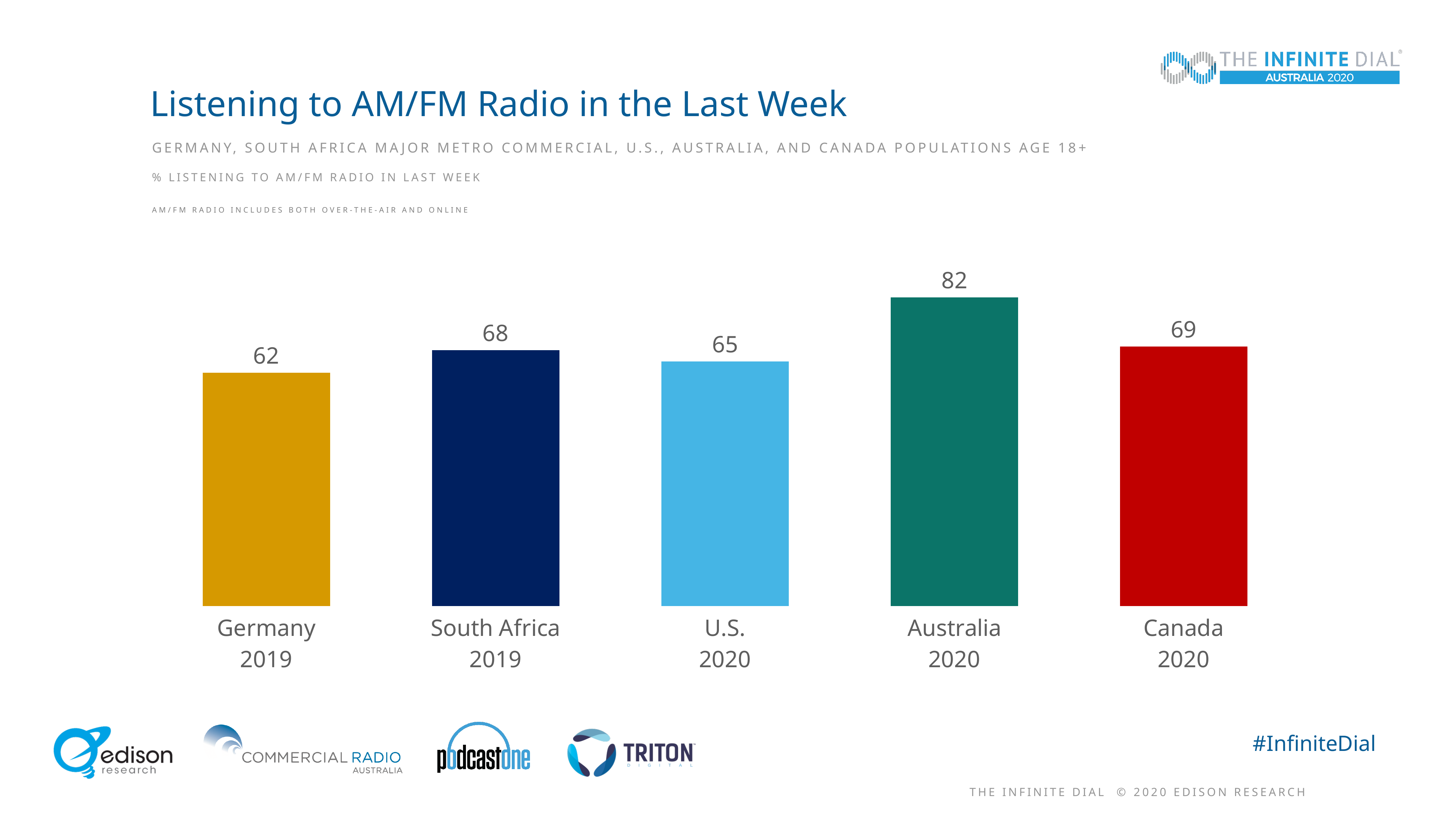
What kind of chart is shown on the slide? Bar chart What is the value for Canada 2020? 69 Which category has the highest value? Australia 2020 What is the title of the chart? Listening to AM/FM Radio in the Last Week Which is larger, the value for Canada 2020 or the value for U.S. 2020? Canada 2020 Which category has the lowest value? Germany 2019 How many categories are shown in the chart? 5 What is the value for U.S. 2020? 65 What is the value for South Africa 2019? 68 What is the difference between the values for Australia 2020 and Germany 2019? 20 What is the value for Australia 2020? 82 What is the value for Germany 2019? 62